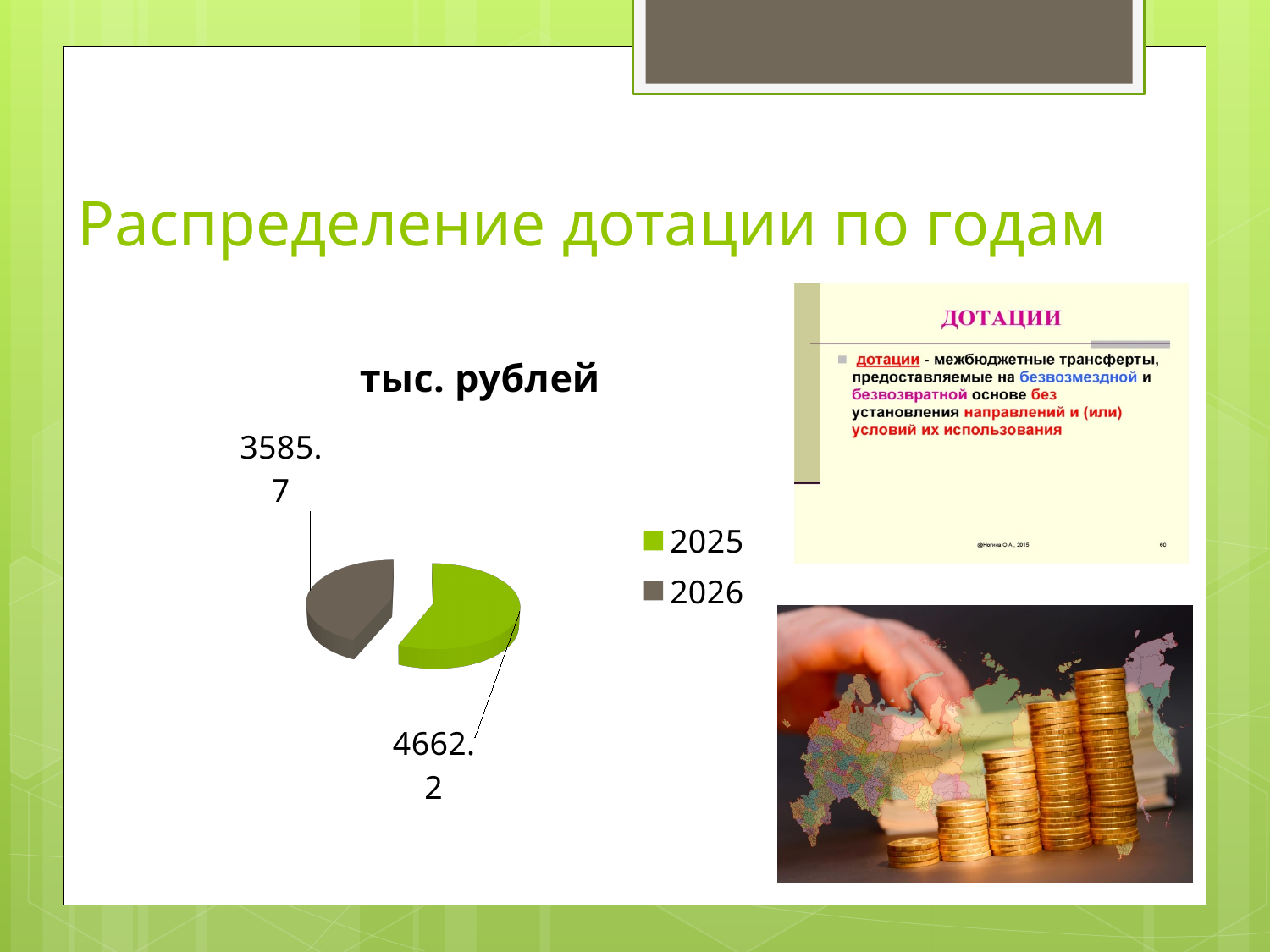
Which year has the smallest slice in the pie chart? 2026 What is the difference between the values for 2025 and 2026 in the pie chart? 1076.5 Which colour represents 2026 in the pie chart legend? grey What is the total of the two values shown in the pie chart? 8247.9 Which year has the largest slice in the pie chart? 2025 What is the value for 2025 in the pie chart? 4662.2 Which is larger in the pie chart, the value for 2025 or the value for 2026? 2025 How many slices does the pie chart have? 2 What type of chart is shown on the slide? pie chart What is the value for 2026 in the pie chart? 3585.7 What is the title of the pie chart? тыс. рублей How many series does the legend of the pie chart list? 2